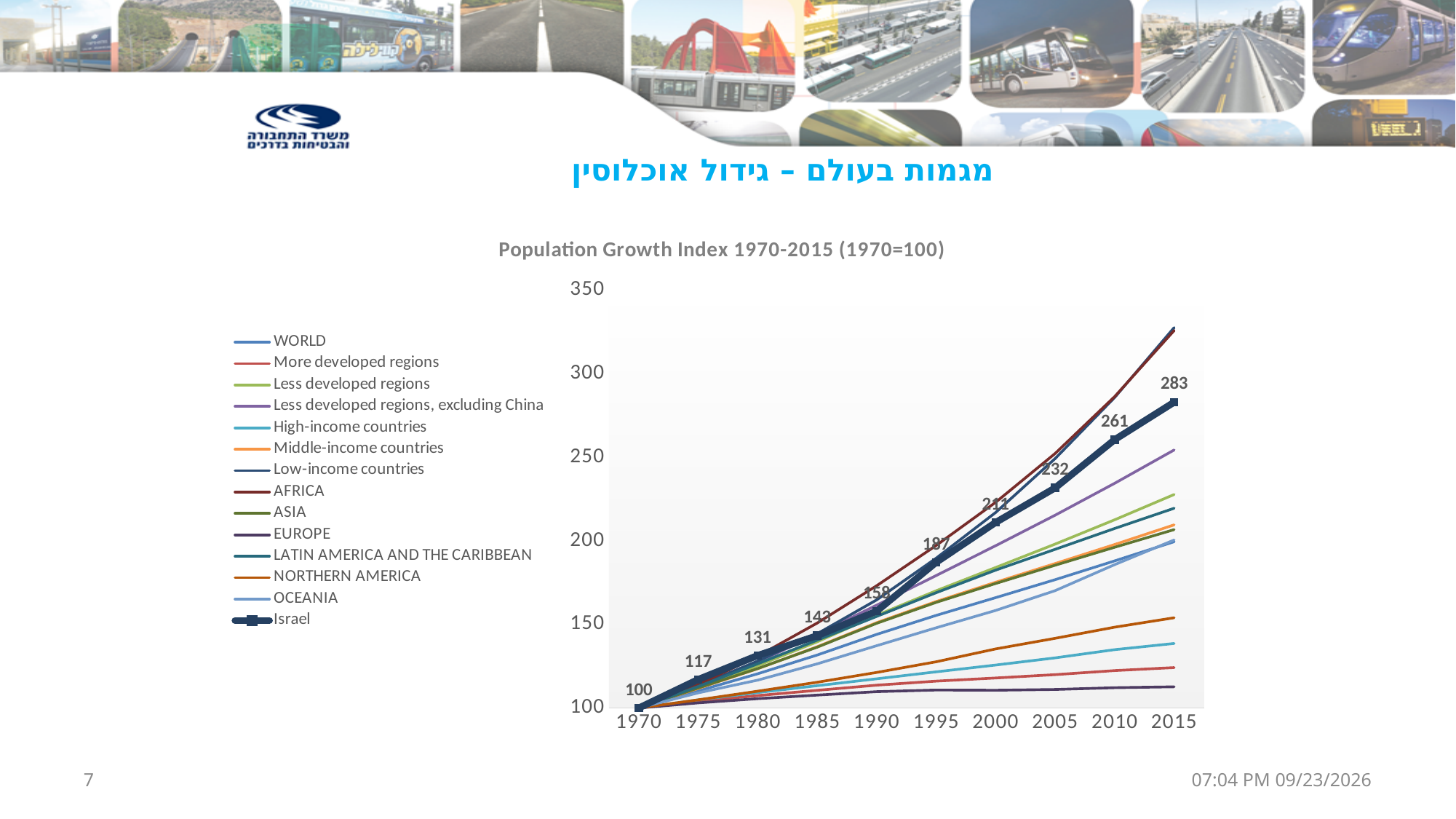
What is the difference between the Israel values for 2015 and 1970? 183 What is the value for Israel in 2010? 261 How many years are shown on the x axis? 10 What is the value for Israel in 2005? 232 Is the value for EUROPE in 2015 greater or less than 150? less Which series has the lowest value in 2015? EUROPE What is the value for Israel in 1975? 117 What is the value for Israel in 2015? 283 What is the difference between the Israel values for 2015 and 2010? 22 How many series does the legend list? 14 What kind of chart is shown on the slide? line chart Is the value for AFRICA in 2015 greater or less than 300? greater